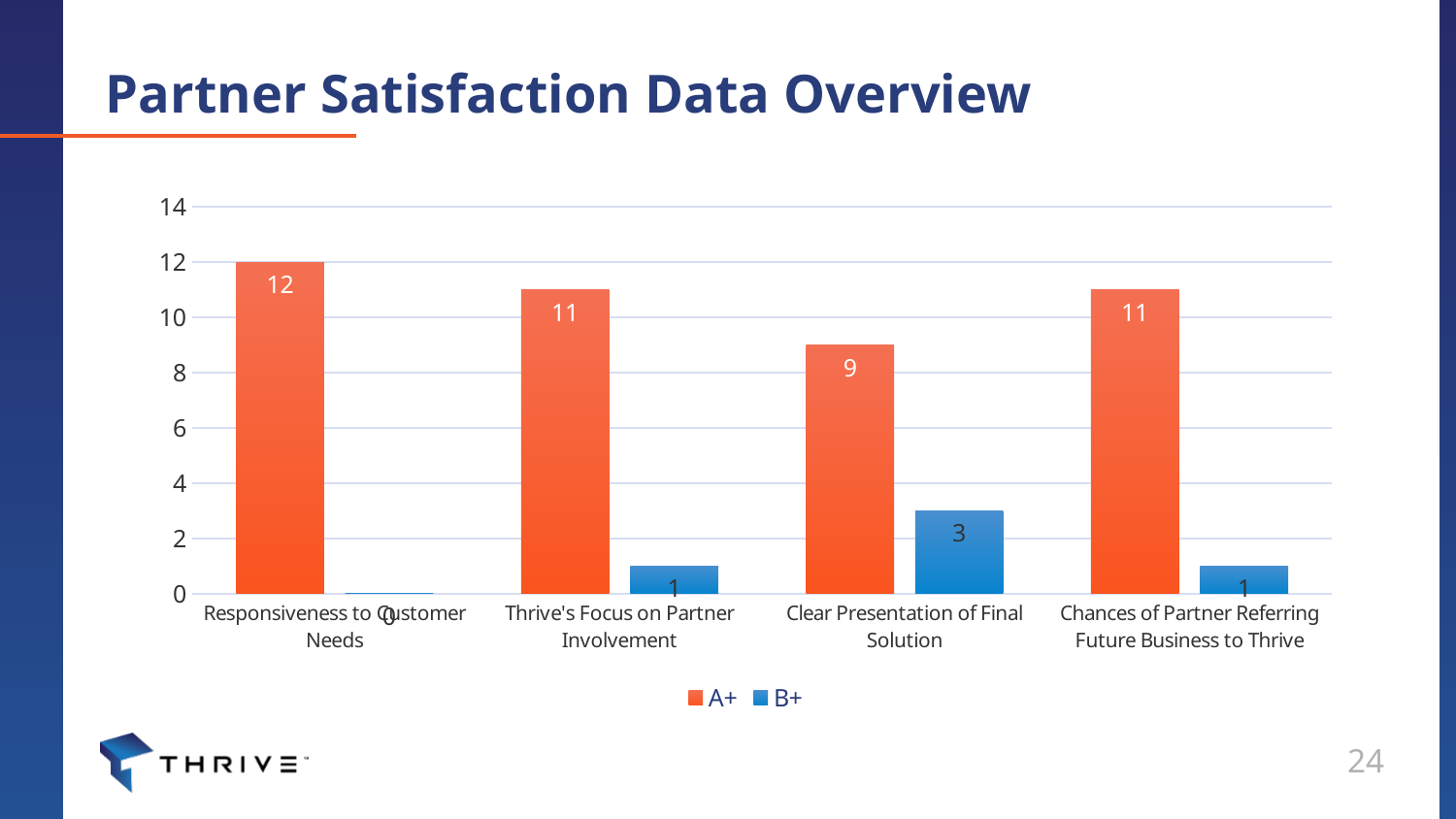
Which is larger: the A+ value for Thrive's Focus on Partner Involvement or the A+ value for Clear Presentation of Final Solution? Thrive's Focus on Partner Involvement How many series does the legend list? 2 What is the difference between the A+ and B+ values for Clear Presentation of Final Solution? 6 What kind of chart is shown on the slide? Bar chart What is the B+ value for Clear Presentation of Final Solution? 3 How many categories are shown on the x axis? 4 What is the A+ value for Clear Presentation of Final Solution? 9 What is the A+ value for Responsiveness to Customer Needs? 12 Which category has the highest B+ value? Clear Presentation of Final Solution Which category has the highest A+ value? Responsiveness to Customer Needs What is the B+ value for Thrive's Focus on Partner Involvement? 1 Which category has the lowest A+ value? Clear Presentation of Final Solution